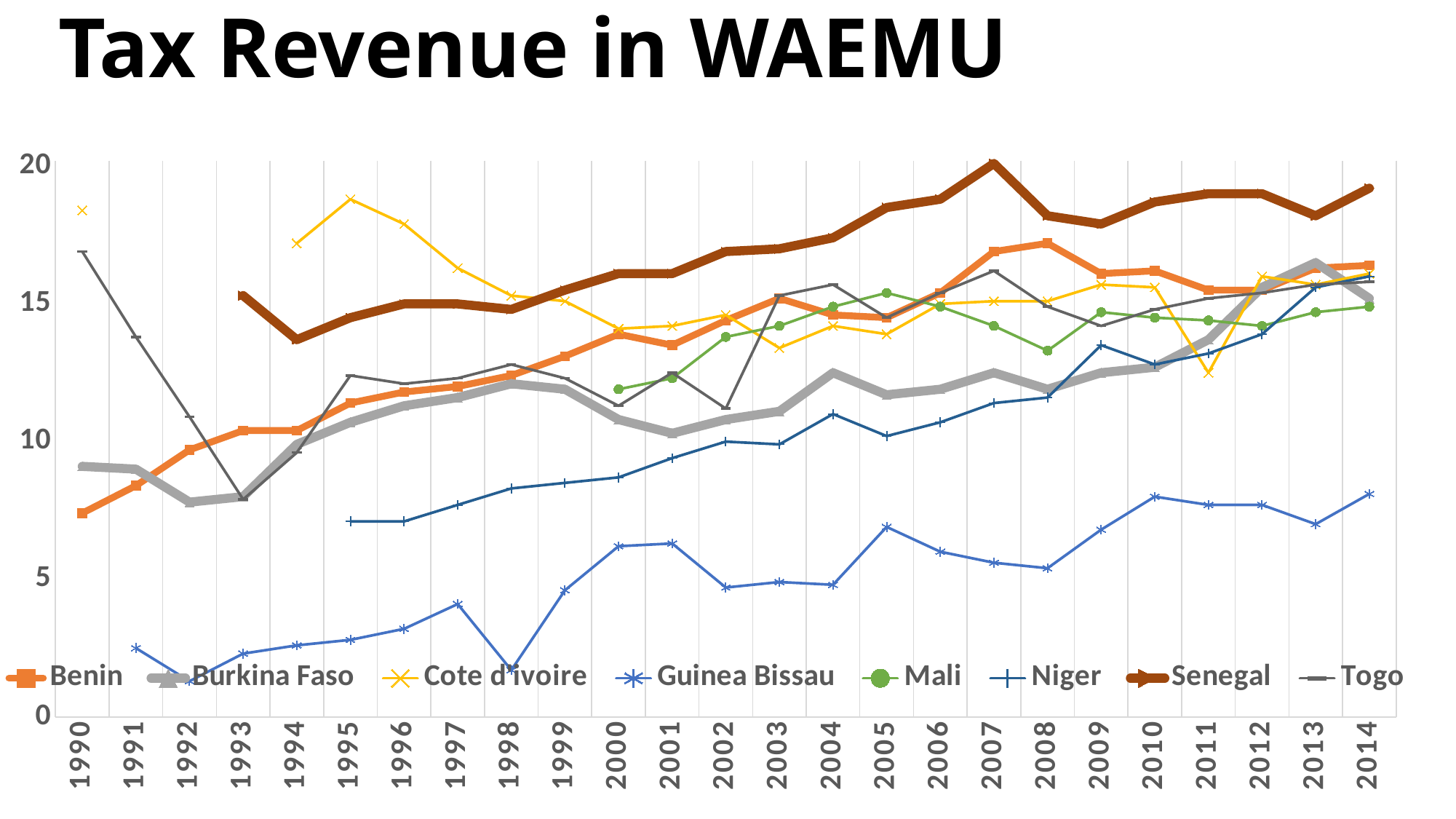
What is the title of the chart? Tax Revenue in WAEMU In 2014, which is larger: the value for Senegal or the value for Guinea Bissau? Senegal What kind of chart is shown on the slide? line chart Is the value for Guinea Bissau in 1998 greater or less than 5? less Which series has the highest value in 2007? Senegal Does the value for Niger generally rise or fall from 1995 to 2014? rise Which series has the lowest value in 2014? Guinea Bissau How many years are shown along the x axis? 25 Is the value for Senegal in 2007 greater or less than 15? greater In 1990, which is larger: the value for Cote d'Ivoire or the value for Benin? Cote d'Ivoire How many series does the legend list? 8 Is the value for Benin in 1990 greater or less than 10? less